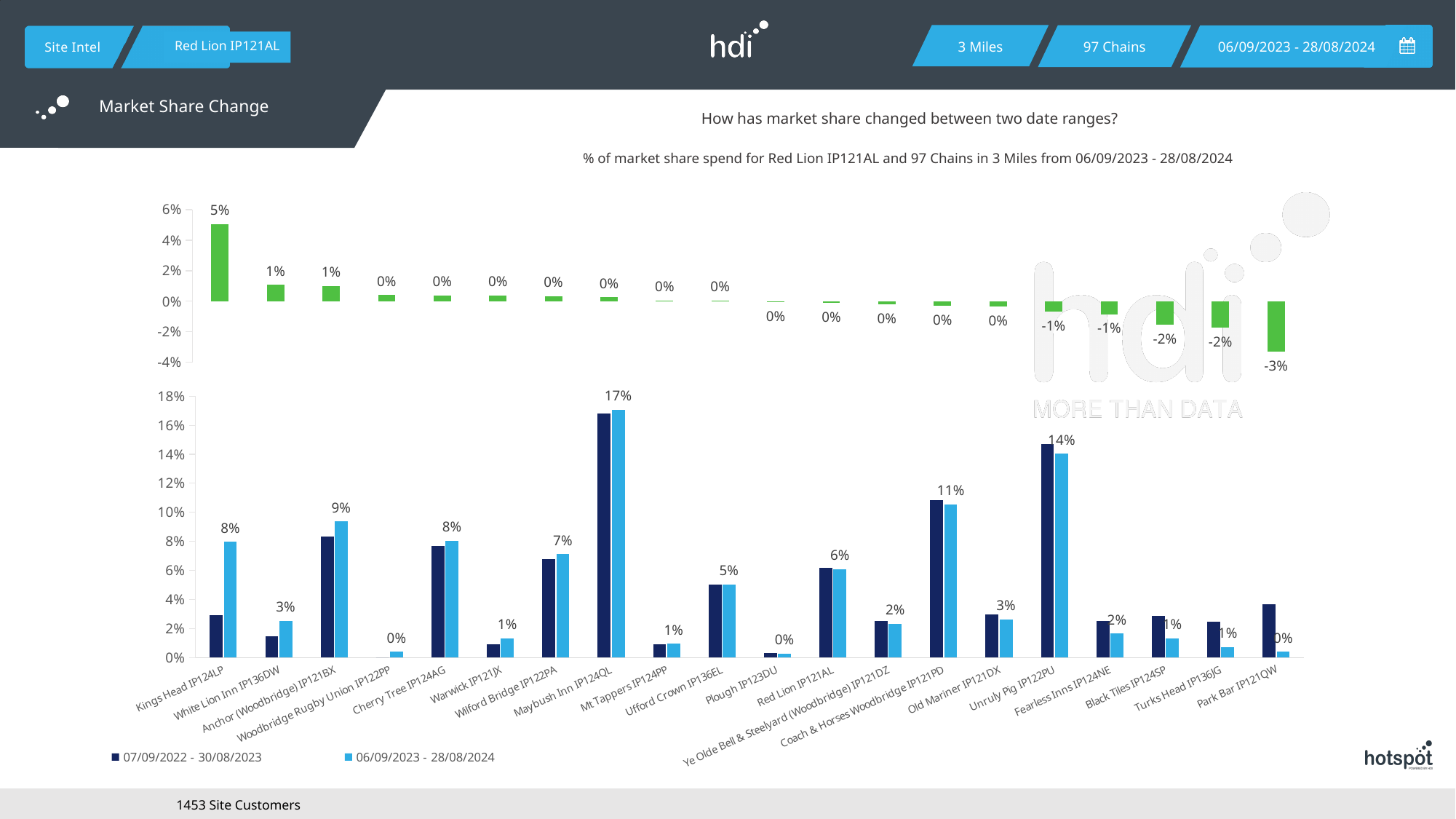
In the bottom chart, which has the larger labelled 06/09/2023 - 28/08/2024 value: Kings Head IP124LP or Anchor (Woodbridge) IP121BX? Anchor (Woodbridge) IP121BX How many categories are shown on the x axis of the bottom chart? 20 In the bottom chart, what is the labelled value for Maybush Inn IP124QL in the 06/09/2023 - 28/08/2024 period? 17% In the top chart (market share change), what is the value for Kings Head IP124LP? 5% In the top chart (market share change), what is the value for Black Tiles IP124SP? -2% How many series does the legend of the bottom chart list? 2 In the bottom chart, what is the labelled value for Coach & Horses Woodbridge IP121PD in the 06/09/2023 - 28/08/2024 period? 11% In the bottom chart, is the 07/09/2022 - 30/08/2023 value for Kings Head IP124LP greater or less than 4%? less In the bottom chart, which category has the highest labelled value for the 06/09/2023 - 28/08/2024 period? Maybush Inn IP124QL In the top chart (market share change), which category has the highest value? Kings Head IP124LP In the top chart (market share change), which category has the lowest value? Park Bar IP121QW In the bottom chart, what is the difference between the labelled 06/09/2023 - 28/08/2024 values for Maybush Inn IP124QL and Unruly Pig IP122PU? 3%